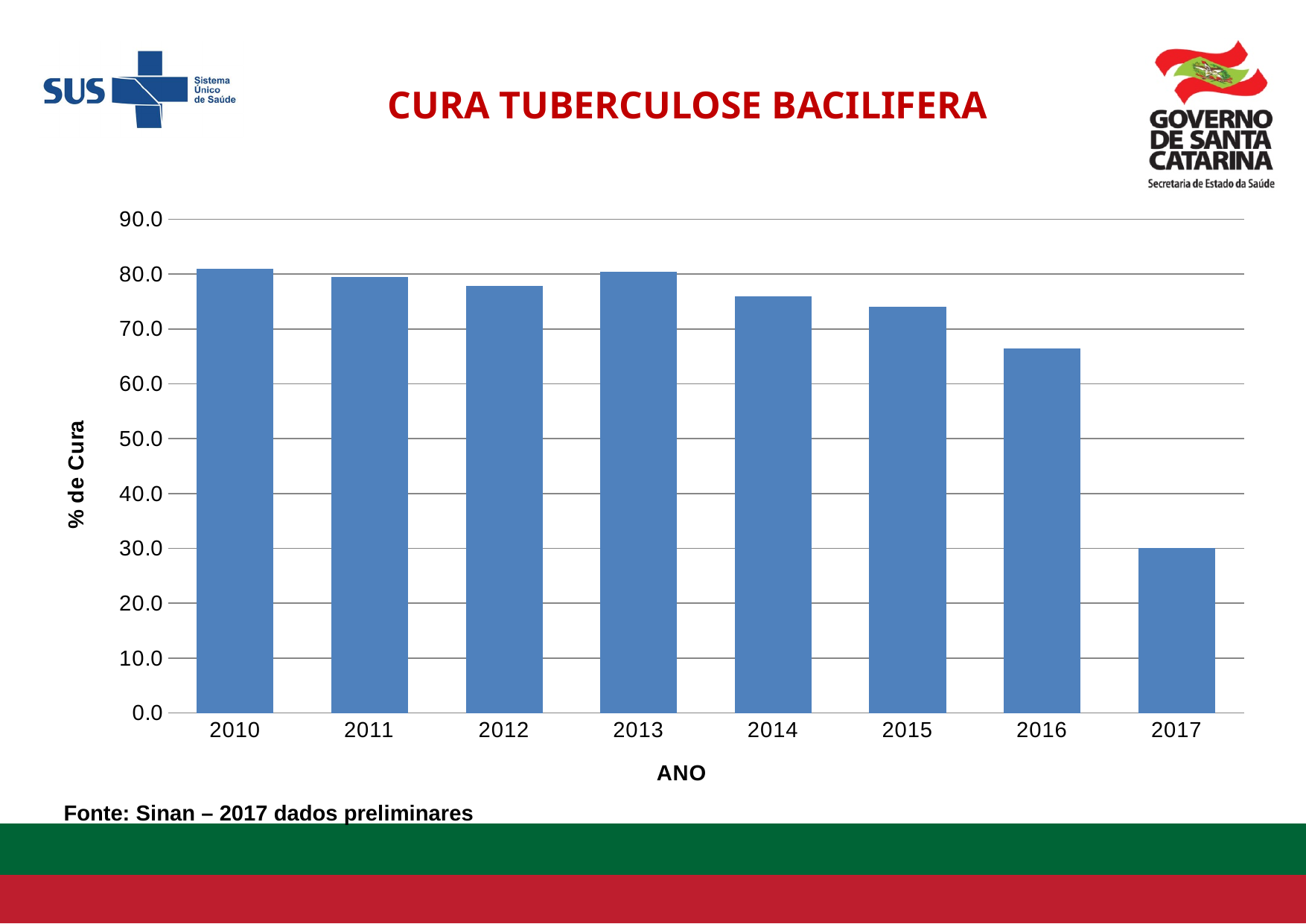
What is the title of the chart? CURA TUBERCULOSE BACILIFERA Which year has the lowest % de Cura? 2017 What kind of chart is shown on the slide? bar chart Is the value for 2017 greater or less than 40.0? less How many years are shown on the x axis? 8 Is the value for 2016 greater or less than 70.0? less Which is larger, the value for 2015 or the value for 2016? 2015 Which is larger, the value for 2013 or the value for 2017? 2013 Is the value for 2014 greater or less than 70.0? greater Do the values generally rise or fall from 2010 to 2017? fall